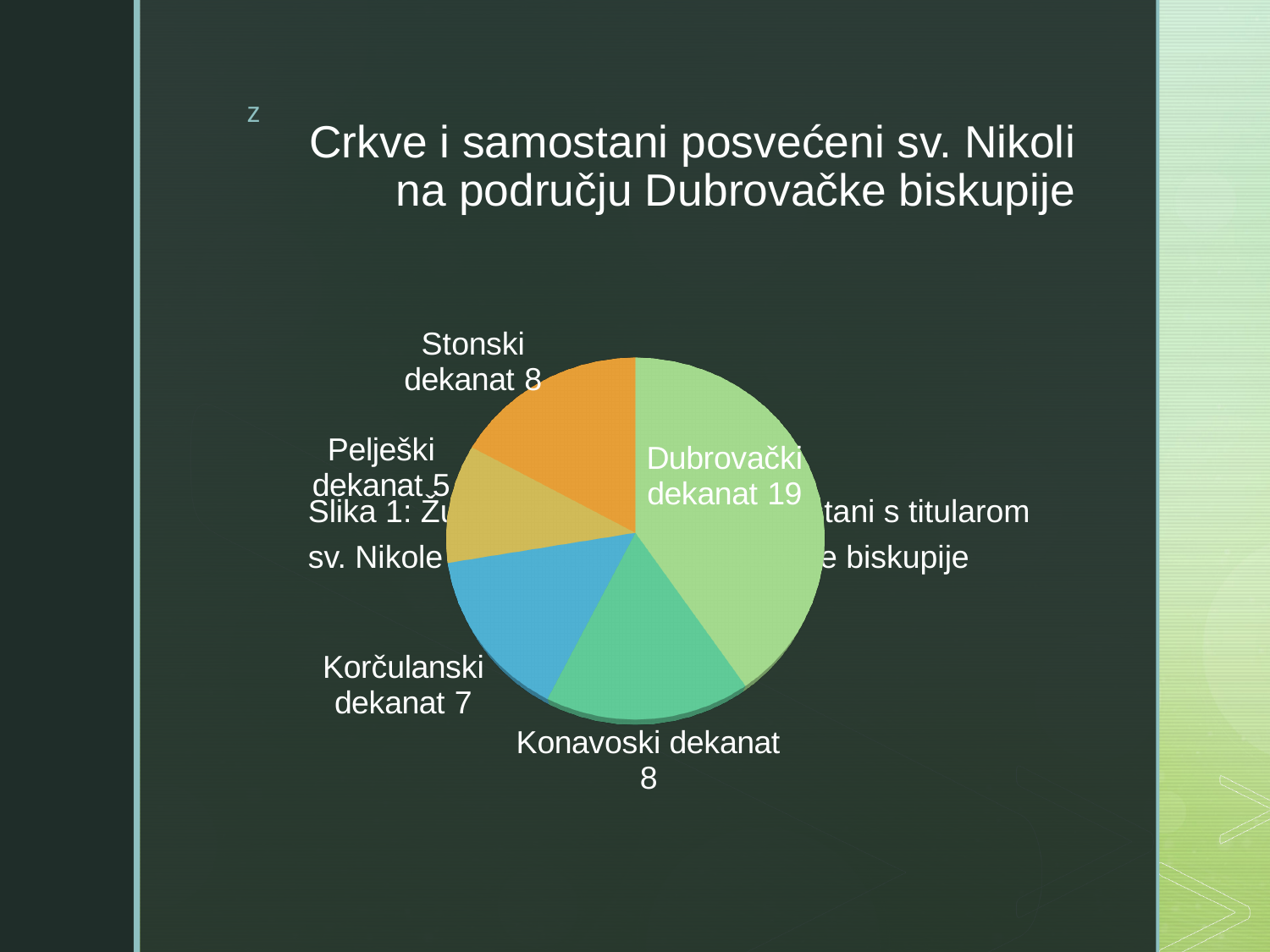
What is the value for Konavoski dekanat? 8 What is the value for Stonski dekanat? 8 What is the value for Korčulanski dekanat? 7 How many slices does the pie chart have? 5 Which dekanat has the smallest slice of the pie? Pelješki dekanat What is the total of all the values shown in the pie chart? 47 What is the value for Dubrovački dekanat? 19 Which dekanat has the largest slice of the pie? Dubrovački dekanat What is the difference between the values for Dubrovački dekanat and Korčulanski dekanat? 12 Which is larger, the value for Korčulanski dekanat or the value for Pelješki dekanat? Korčulanski dekanat What kind of chart is shown on the slide? pie chart What is the value for Pelješki dekanat? 5